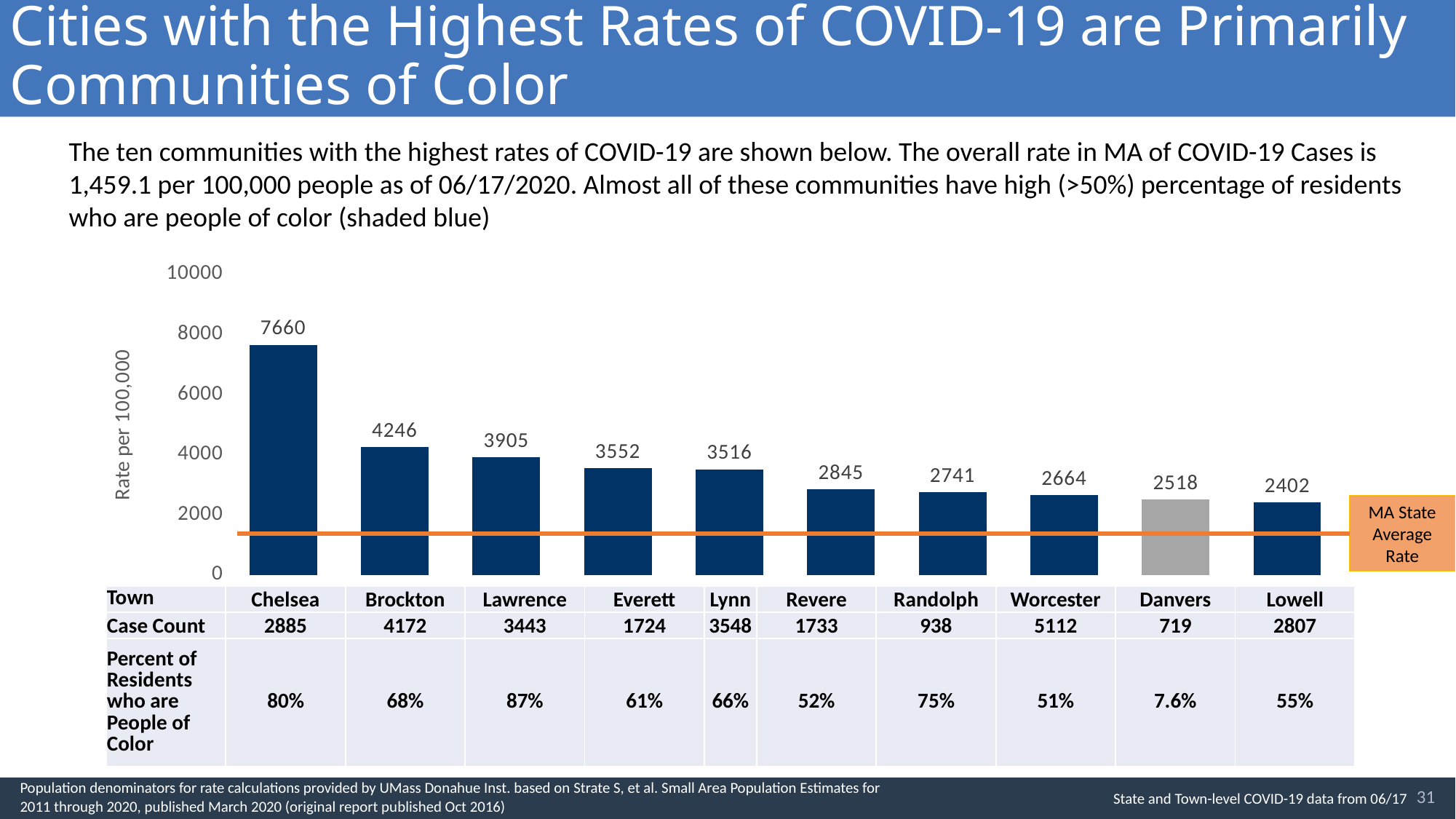
What is the rate per 100,000 for Danvers? 2518 Is the rate per 100,000 for Worcester greater or less than 2000? greater What does the orange horizontal line on the chart represent? MA State Average Rate What is the difference between the rate per 100,000 for Brockton and Lawrence? 341 Which town has the lowest rate per 100,000 among those shown? Lowell Do the rates per 100,000 rise or fall from left to right across the towns? fall What kind of chart is shown on the slide? bar chart What is the rate per 100,000 for Chelsea? 7660 Which has a higher rate per 100,000, Everett or Revere? Everett Which town's bar is shaded gray instead of blue? Danvers How many towns are shown in the chart? 10 Which town has the highest rate per 100,000? Chelsea